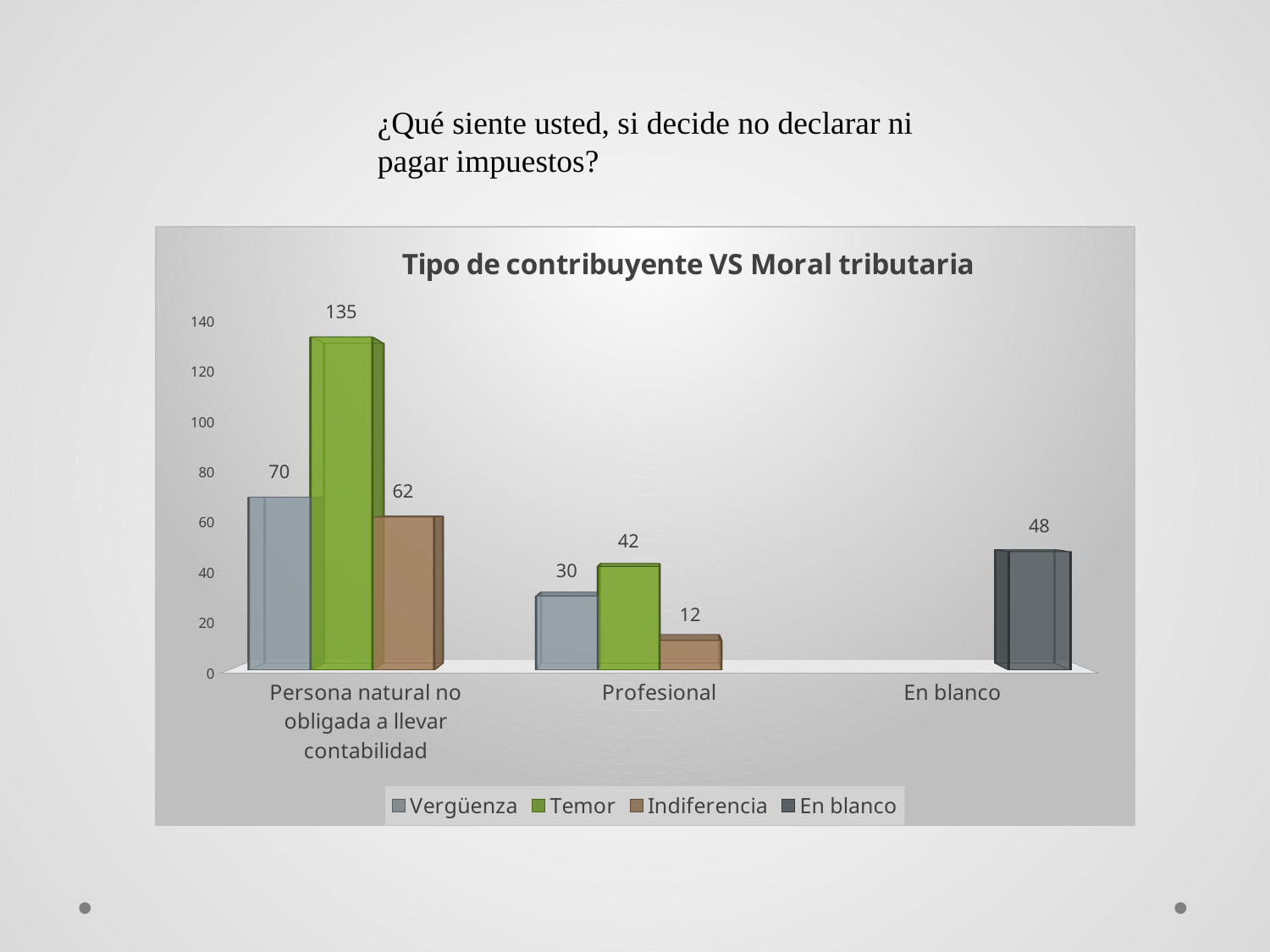
What is the value for Indiferencia in the Profesional category? 12 What kind of chart is shown on the slide? Bar chart What is the title of the chart? Tipo de contribuyente VS Moral tributaria Which series has the highest value in the 'Persona natural no obligada a llevar contabilidad' category? Temor What is the value for Temor in the 'Persona natural no obligada a llevar contabilidad' category? 135 How many categories are shown on the x axis? 3 What is the value for the En blanco category? 48 Which is larger: Vergüenza for 'Persona natural no obligada a llevar contabilidad' or Indiferencia for the same category? Vergüenza What is the difference between the Temor values for 'Persona natural no obligada a llevar contabilidad' and Profesional? 93 How many series does the legend list? 4 What is the value for Vergüenza in the Profesional category? 30 Which series has the lowest value in the Profesional category? Indiferencia